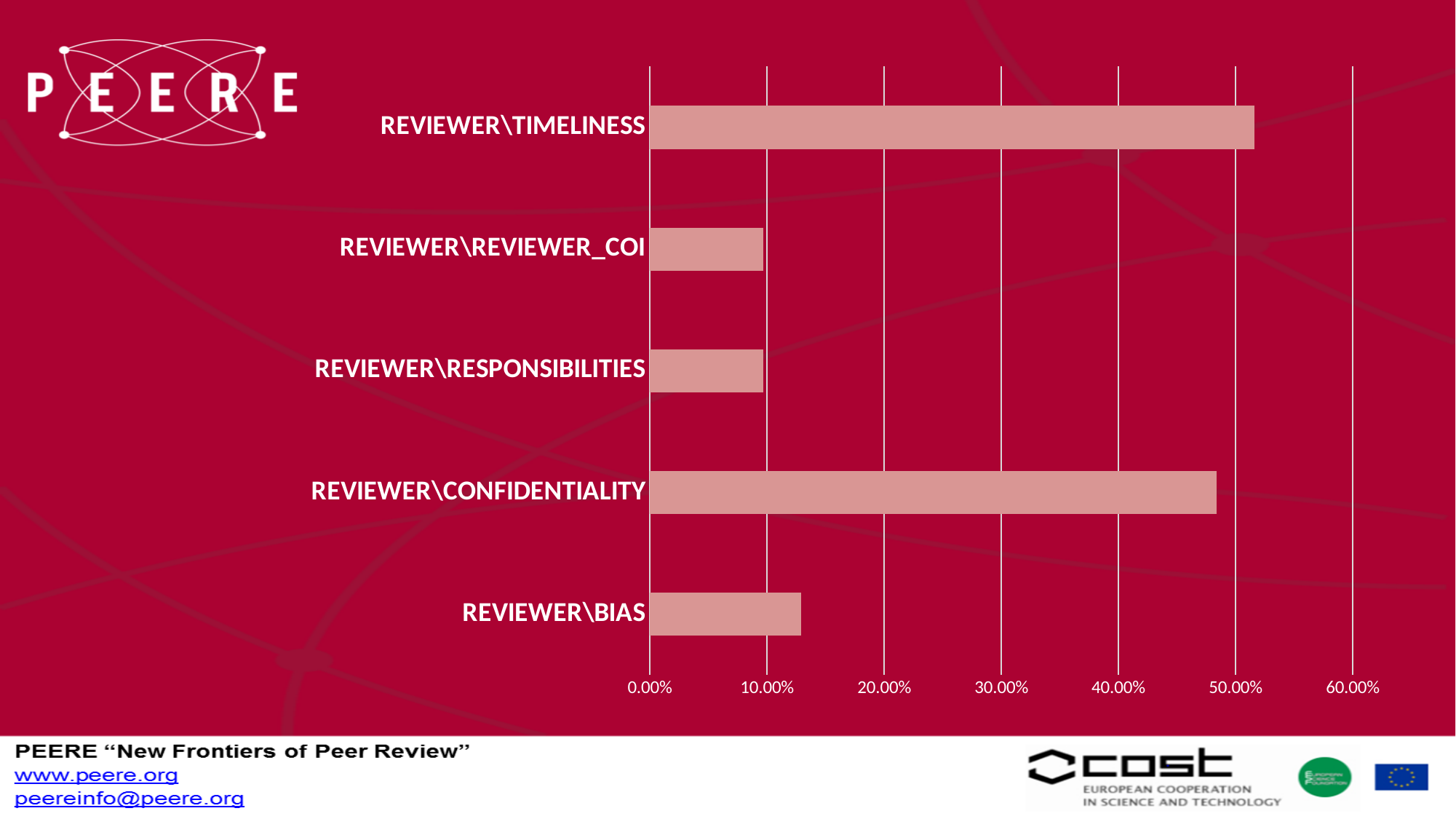
Which category is listed at the bottom of the chart? REVIEWER\BIAS Which is larger, the value for REVIEWER\TIMELINESS or REVIEWER\CONFIDENTIALITY? REVIEWER\TIMELINESS What is the highest tick label shown on the horizontal axis? 60.00% Is the value for REVIEWER\TIMELINESS greater or less than 50.00%? greater Which category has the highest value? REVIEWER\TIMELINESS What kind of chart is shown on the slide? bar chart Is the value for REVIEWER\CONFIDENTIALITY greater or less than 50.00%? less Which is larger, the value for REVIEWER\BIAS or REVIEWER\REVIEWER_COI? REVIEWER\BIAS Is the value for REVIEWER\BIAS greater or less than 10.00%? greater How many categories are plotted in the chart? 5